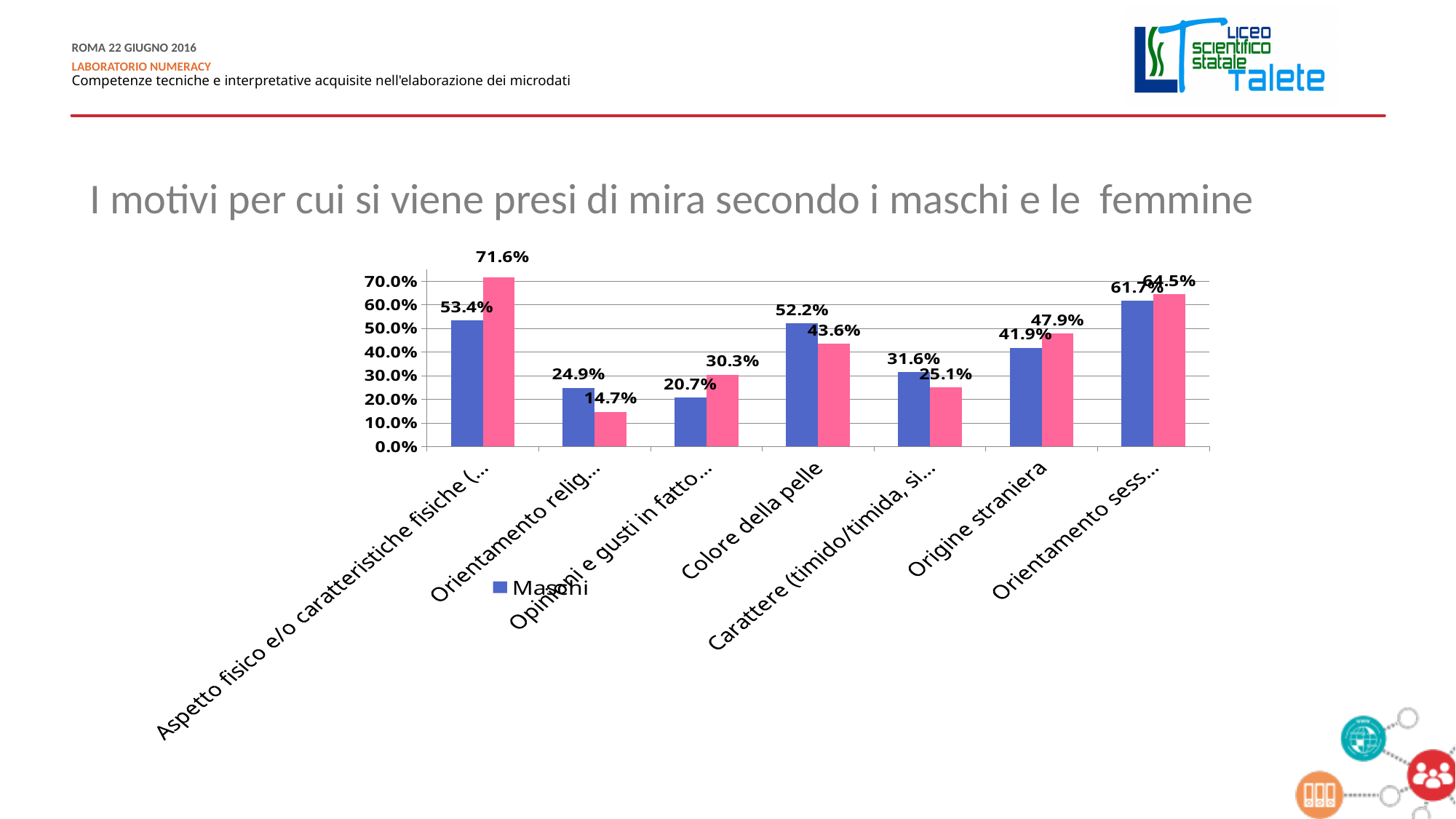
What type of chart is shown on the slide? bar chart What is the difference between the pink (femmine) bar and the Maschi bar for Colore della pelle? 8.6% What is the Maschi value for Colore della pelle? 52.2% What is the value of the pink (femmine) bar for Colore della pelle? 43.6% How many categories are shown on the x axis? 7 For Origine straniera, which is larger: the Maschi bar or the pink (femmine) bar? the pink (femmine) bar What is the title of the slide above the chart? I motivi per cui si viene presi di mira secondo i maschi e le femmine Which category has the lowest Maschi value? Opinioni e gusti in fatto... What is the value of the pink (femmine) bar for Origine straniera? 47.9% Is the Maschi value for Colore della pelle greater or less than 50.0%? greater Which category has the highest pink (femmine) bar? Aspetto fisico e/o caratteristiche fisiche What is the Maschi value for Origine straniera? 41.9%